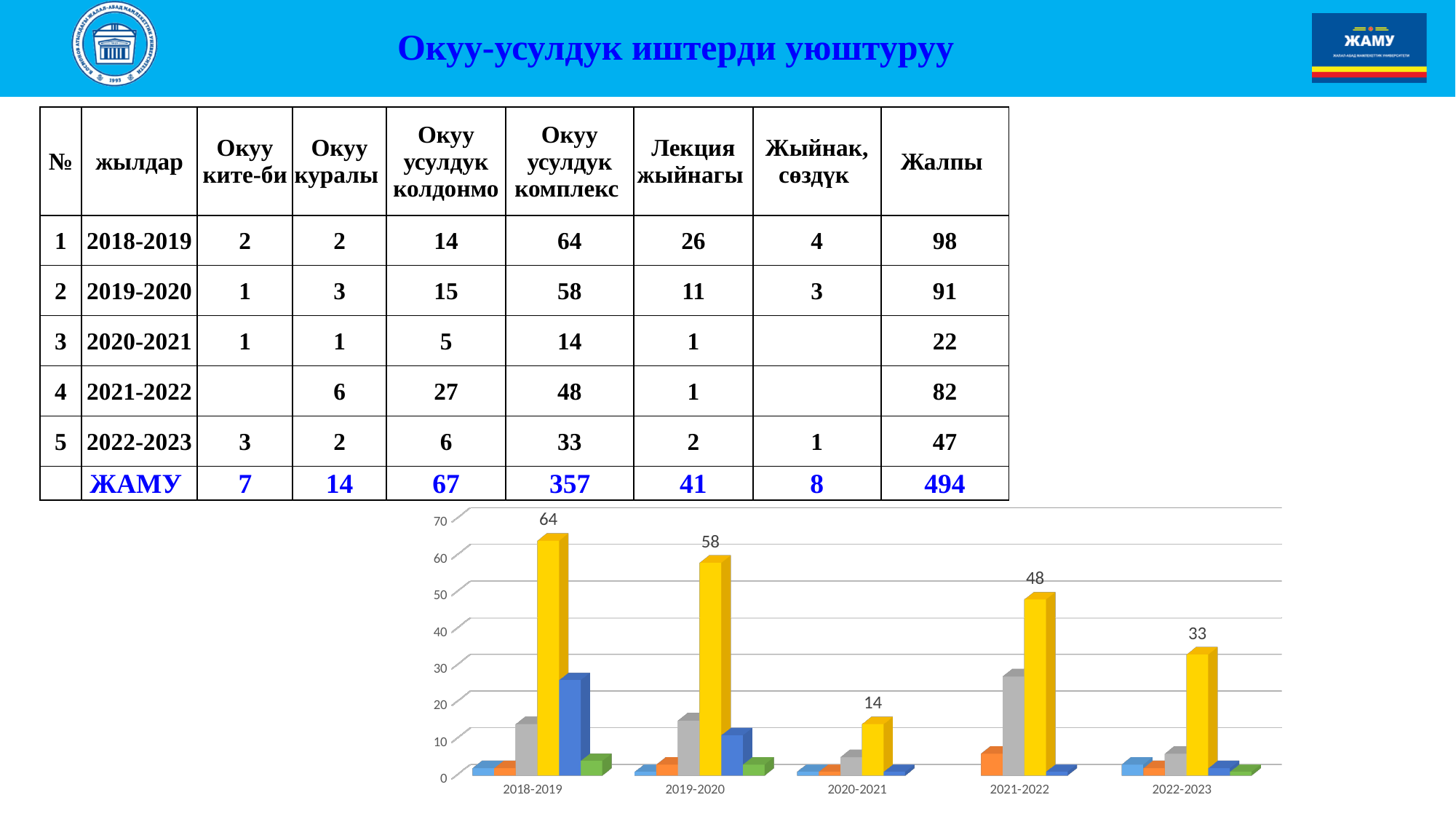
What is the labelled value of the yellow bar for 2021-2022? 48 Which year group has the highest labelled yellow bar? 2018-2019 Which has the larger labelled yellow bar, 2019-2020 or 2021-2022? 2019-2020 Is the value of the dark blue bar for 2018-2019 greater or less than 20? greater What is the difference between the labelled yellow bar values for 2021-2022 and 2022-2023? 15 What kind of chart is shown below the table? bar chart Is the value of the grey bar for 2021-2022 greater or less than 20? greater How many year groups are shown on the x axis of the chart? 5 What is the labelled value of the yellow bar for 2022-2023? 33 What is the difference between the labelled yellow bar values for 2018-2019 and 2019-2020? 6 What is the labelled value of the yellow bar for 2018-2019? 64 Which year group has the lowest labelled yellow bar? 2020-2021